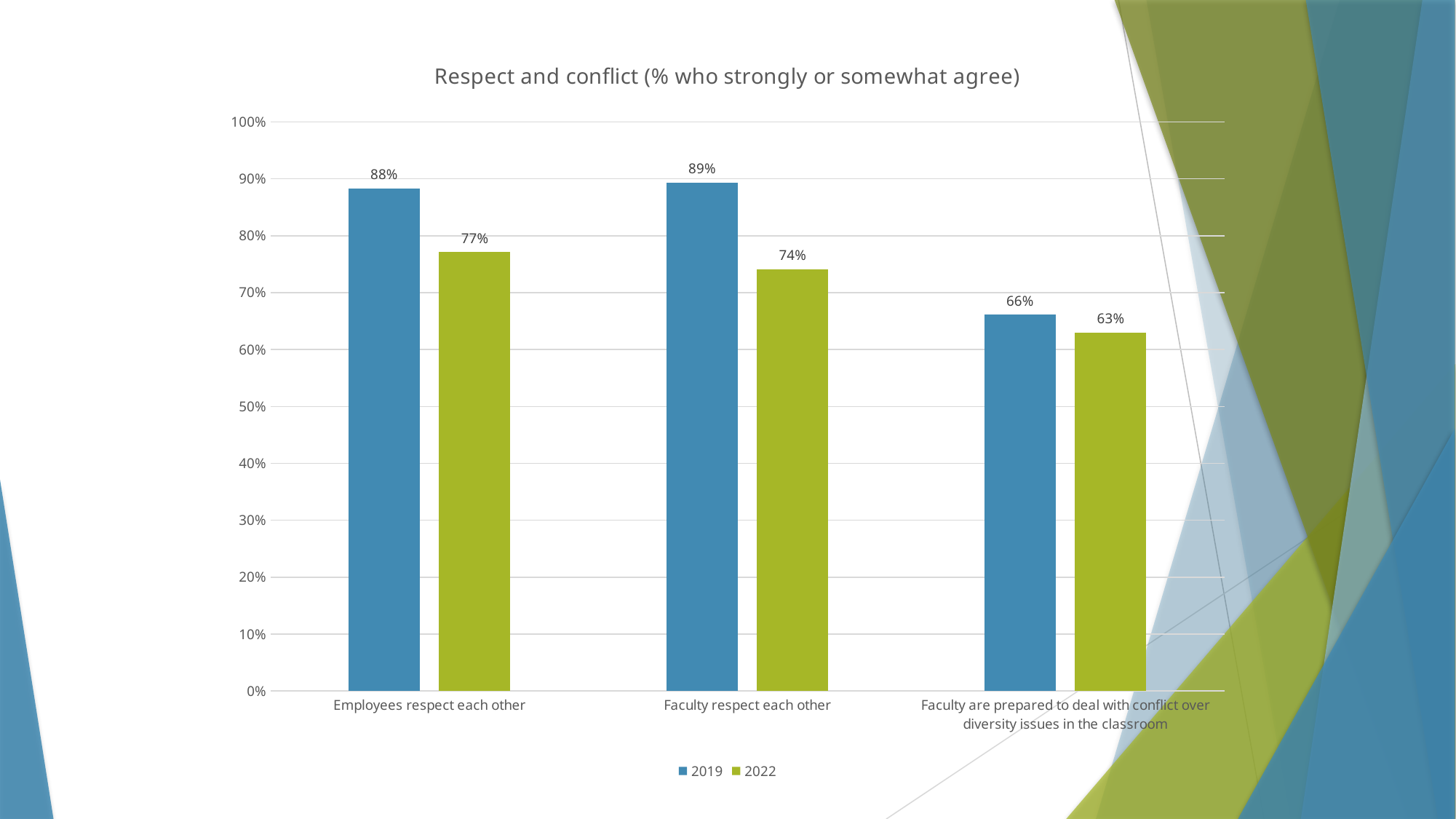
What is the 2022 value for "Faculty are prepared to deal with conflict over diversity issues in the classroom"? 63% What is the 2022 value for "Faculty respect each other"? 74% What is the 2019 value for "Employees respect each other"? 88% Which is larger for "Faculty respect each other": the 2019 value or the 2022 value? 2019 Which category has the lowest 2022 value? Faculty are prepared to deal with conflict over diversity issues in the classroom How many series does the legend list? 2 Which series is shown in green? 2022 What kind of chart is shown on the slide? Bar chart What is the difference between the 2019 and 2022 values for "Employees respect each other"? 11% How many categories are shown on the x axis? 3 Which category has the highest 2019 value? Faculty respect each other What is the title of the chart? Respect and conflict (% who strongly or somewhat agree)